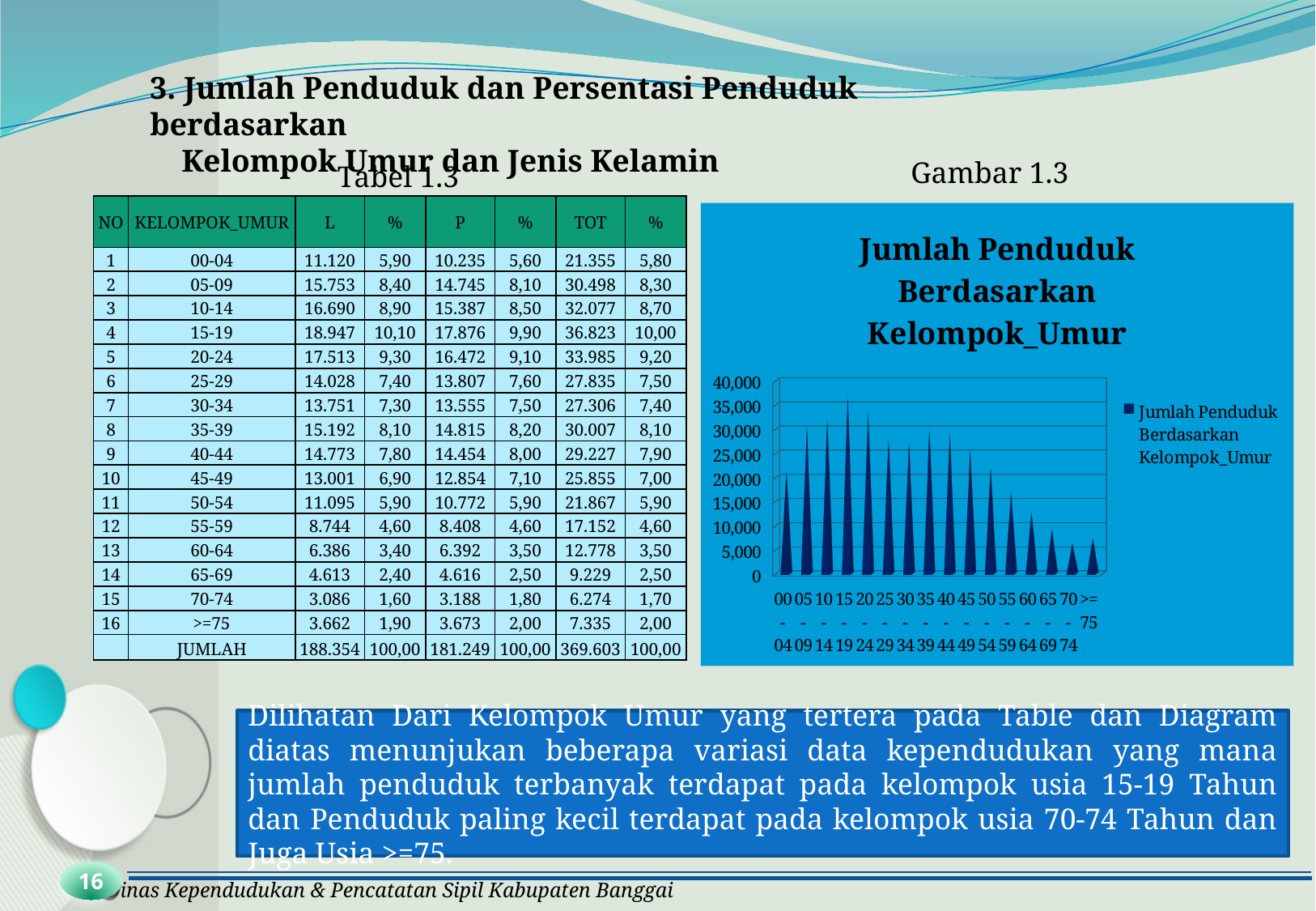
In the chart, do the values generally rise or fall from the 15-19 age group to the 70-74 age group? fall What is the title of the chart in Gambar 1.3? Jumlah Penduduk Berdasarkan Kelompok_Umur In the chart, is the value for the 55-59 age group greater or less than 20,000? less How many series does the legend of the chart list? 1 Which age group has the lowest value in the chart? 70-74 Which age group has the highest value in the chart? 15-19 In the chart, is the value for the 25-29 age group greater or less than 30,000? less In the chart, is the value for the 20-24 age group greater or less than 30,000? greater How many age-group categories are plotted on the x axis of the chart? 16 In the chart, which is larger, the value for 15-19 or the value for 20-24? 15-19 What kind of chart is shown in Gambar 1.3? bar chart